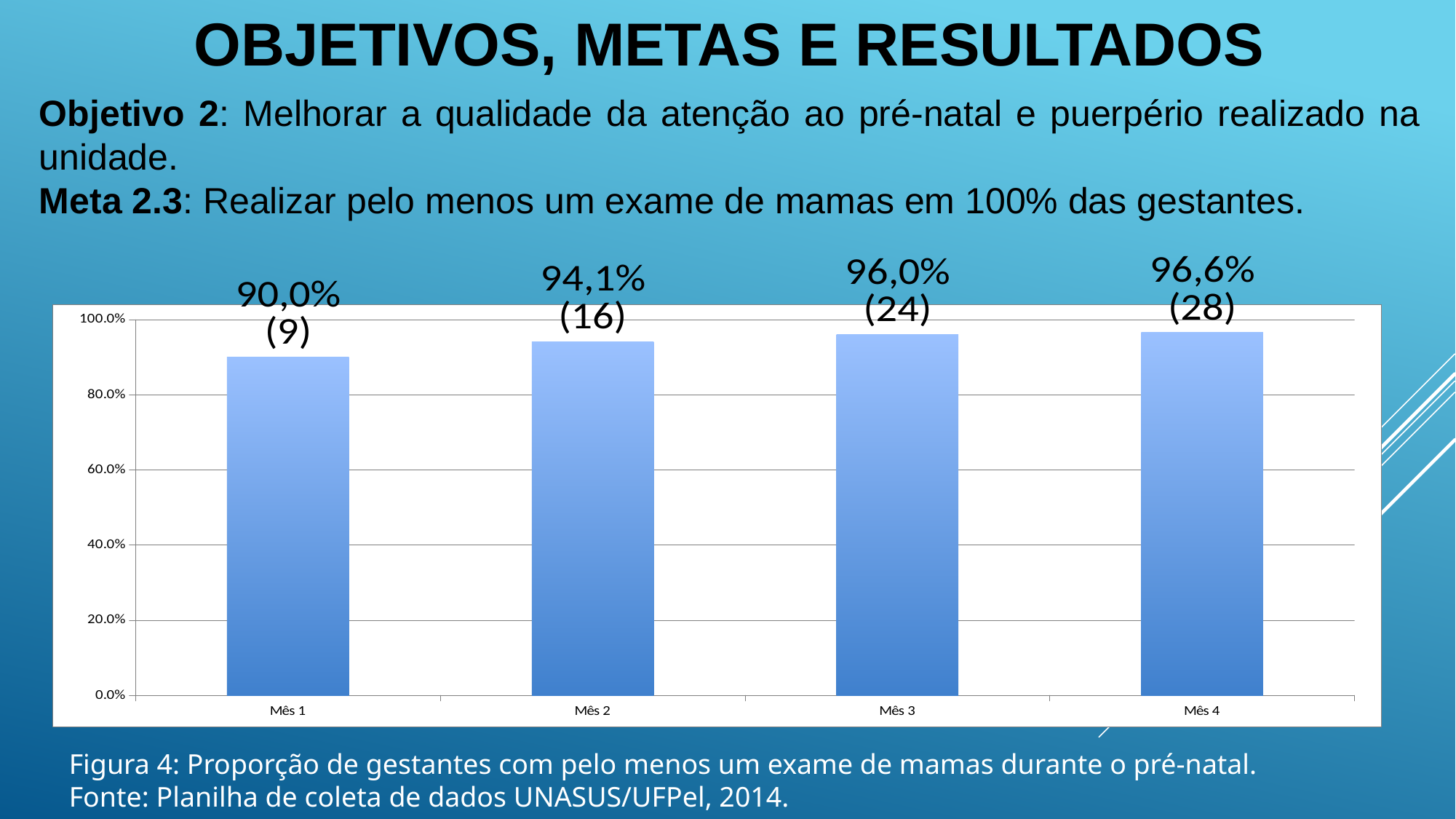
Is the value for Mês 1 greater or less than 80.0%? greater What is the difference in percentage points between Mês 2 and Mês 1? 4,1 What is the value for Mês 1? 90,0% What is the value for Mês 4? 96,6% How many pregnant women (the number in parentheses) are shown for Mês 2? 16 Which month has the highest value? Mês 4 What is the value for Mês 3? 96,0% How many months (categories) are shown on the x axis? 4 What kind of chart is shown on the slide? bar chart Which month has the lowest value? Mês 1 Do the values rise or fall from Mês 1 to Mês 4? rise Which is larger, the value for Mês 2 or the value for Mês 3? Mês 3